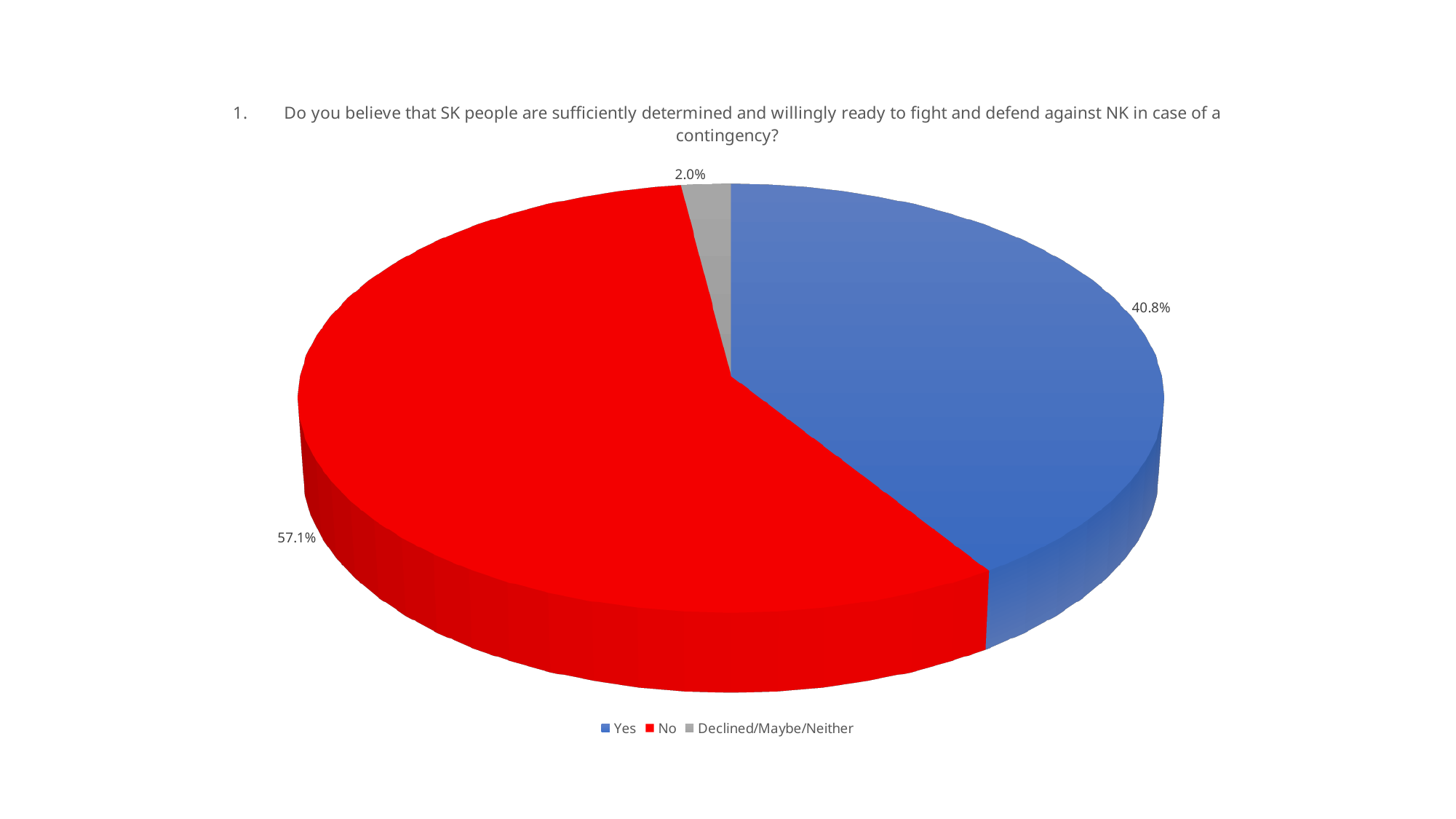
Which response has the smallest share of the pie? Declined/Maybe/Neither Which is larger, the share for "Yes" or the share for "No"? No What is the difference in percentage points between the "No" and "Yes" shares? 16.3 What colour is the "Yes" slice? blue What percentage of respondents answered "Yes"? 40.8% Which response has the largest share of the pie? No What percentage of respondents answered "No"? 57.1% How many slices does the pie chart have? 3 What kind of chart is shown on the slide? pie chart How many entries does the legend list? 3 What percentage is shown for "Declined/Maybe/Neither"? 2.0% What colour is the "No" slice? red